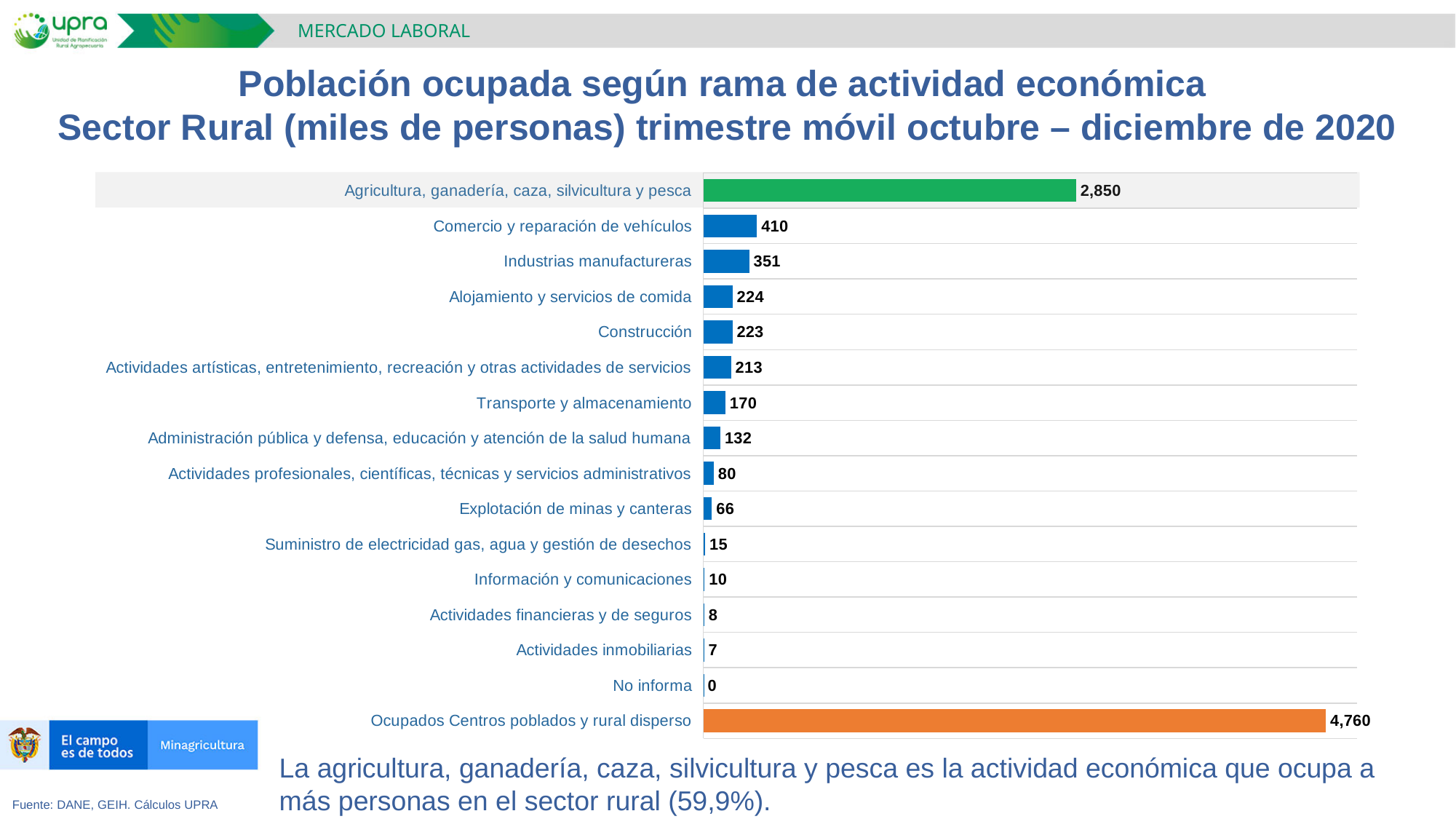
What kind of chart is shown on the slide? Bar chart What is the value for Ocupados Centros poblados y rural disperso? 4,760 Which is larger, Transporte y almacenamiento or Administración pública y defensa, educación y atención de la salud humana? Transporte y almacenamiento What is the value for Agricultura, ganadería, caza, silvicultura y pesca? 2,850 What is the value for Comercio y reparación de vehículos? 410 Which category has the highest value? Ocupados Centros poblados y rural disperso What is the value for Industrias manufactureras? 351 How many bars are shown in the chart? 16 Which category has the lowest value? No informa What is the value for Explotación de minas y canteras? 66 What is the difference between Comercio y reparación de vehículos and Industrias manufactureras? 59 What is the difference between Agricultura, ganadería, caza, silvicultura y pesca and Comercio y reparación de vehículos? 2,440